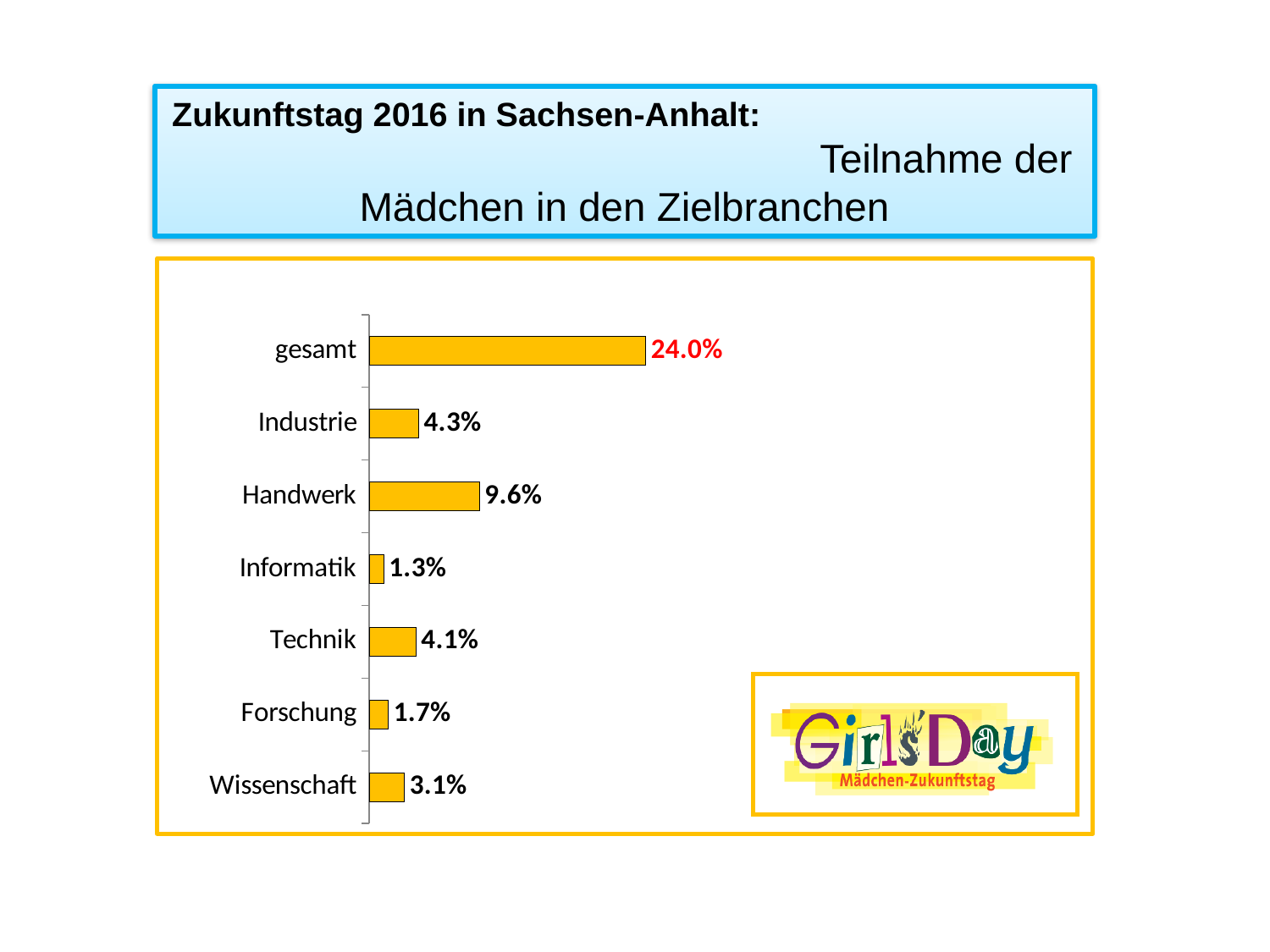
Which category has the lowest value? Informatik What is the difference between the values for Handwerk and Industrie? 5.3% What kind of chart is shown on the slide? bar chart What is the difference between the values for Technik and Forschung? 2.4% What is the value for Informatik? 1.3% What is the value for Wissenschaft? 3.1% Which category has the highest value? gesamt Which is larger, the value for Industrie or the value for Wissenschaft? Industrie What is the value for Handwerk? 9.6% What is the value for gesamt? 24.0% How many categories are shown in the chart? 7 What colour are the bars in the chart? orange